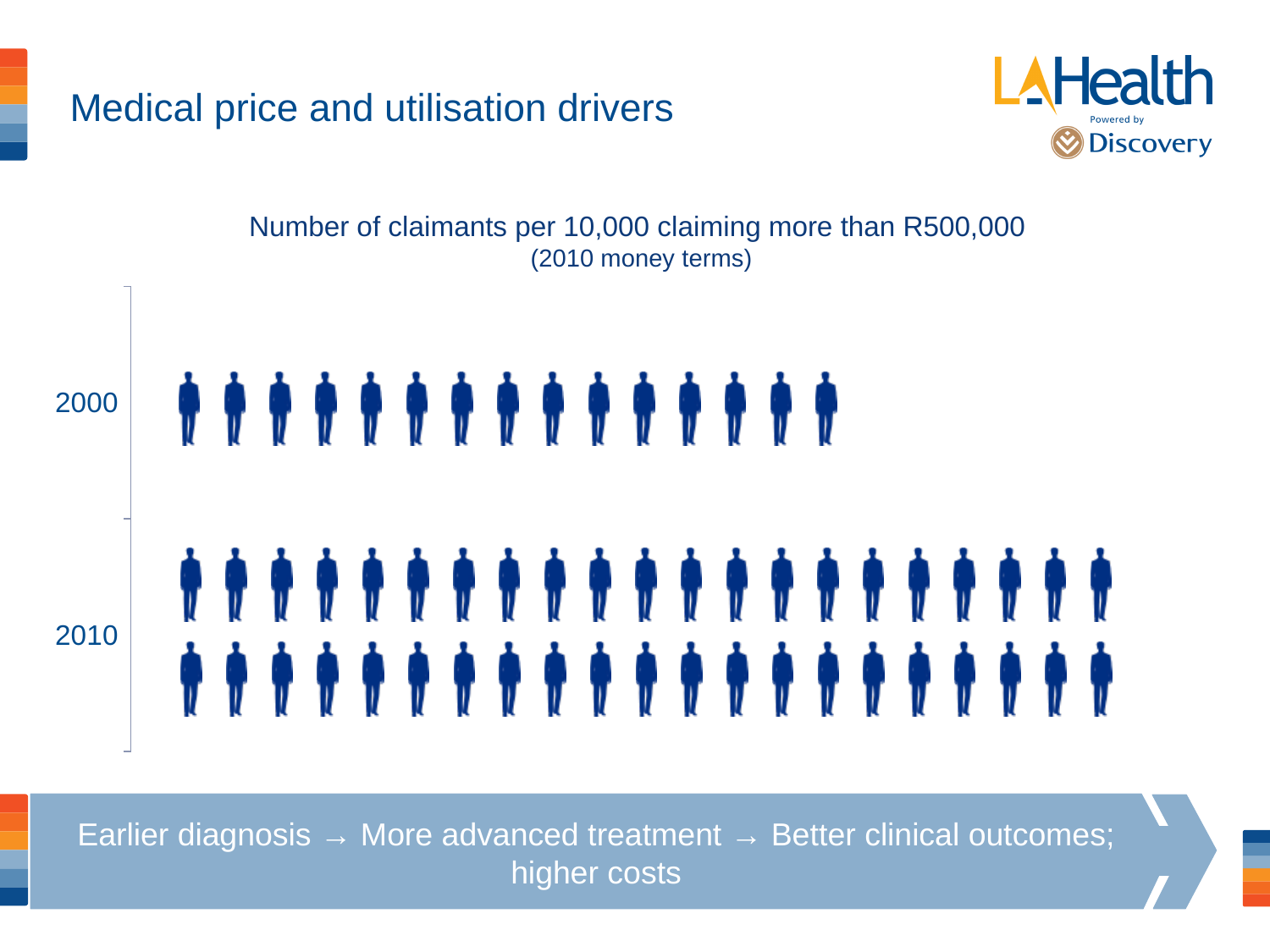
How many years (categories) does the chart compare? 2 What kind of chart is shown on the slide? Pictogram (icon chart) Is the number of claimants larger in 2000 or in 2010? 2010 Does the number of claimants per 10,000 claiming more than R500,000 rise or fall from 2000 to 2010? Rise How many person icons are shown for the year 2000? 15 How many person icons are shown in total for the year 2010? 42 Which year shows the higher number of claimants per 10,000 claiming more than R500,000? 2010 Which year shows the lower number of claimants per 10,000 claiming more than R500,000? 2000 In what money terms are the values expressed, according to the chart subtitle? 2010 money terms What is the title of the chart? Number of claimants per 10,000 claiming more than R500,000